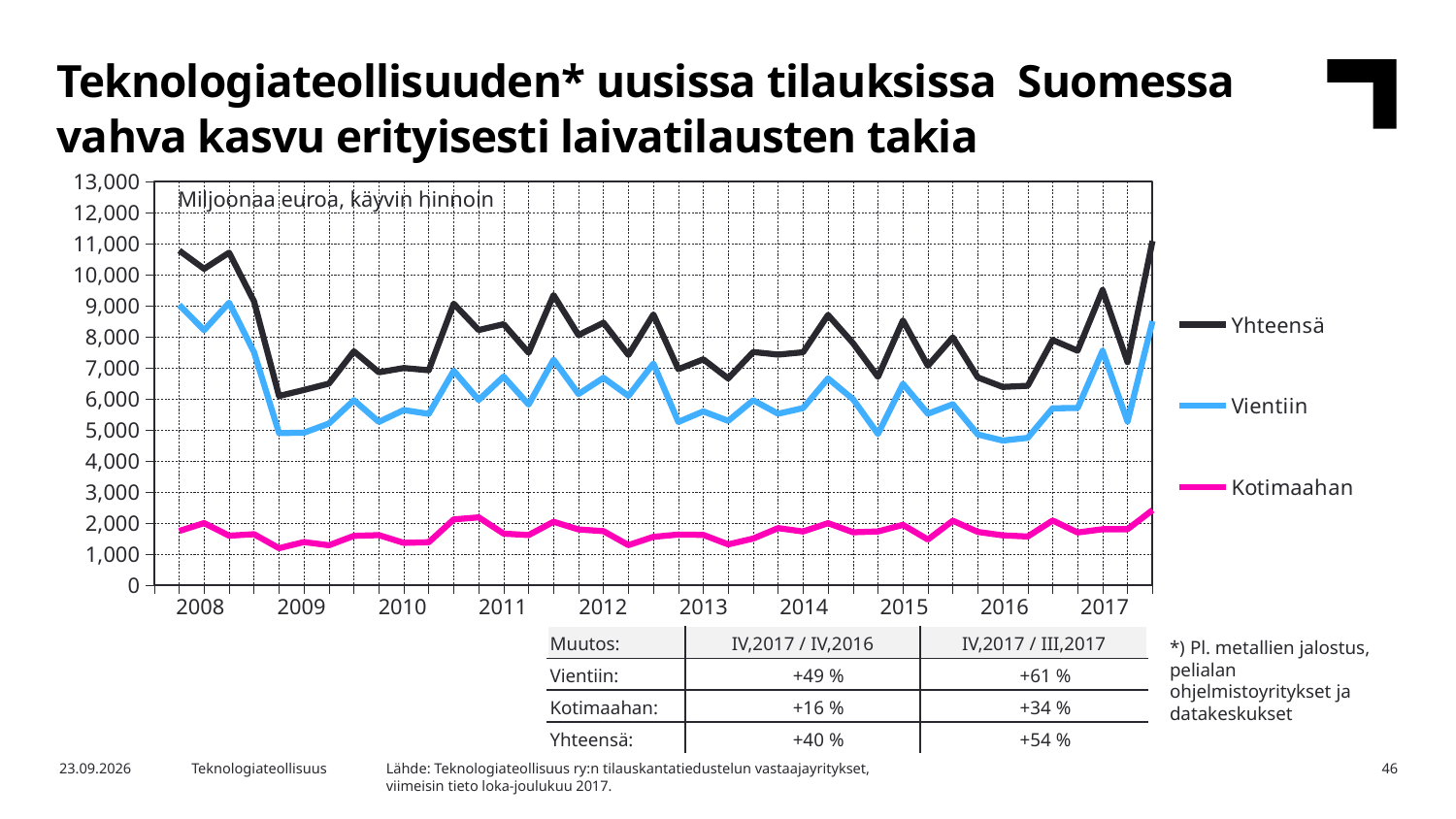
What unit label is printed inside the chart area? Miljoonaa euroa, käyvin hinnoin Which series is shown in black in the chart? Yhteensä Which series is larger at the start of 2008, Vientiin or Kotimaahan? Vientiin Is the last plotted value for Yhteensä in 2017 greater or less than 10,000? greater How many series does the chart legend list? 3 Is the value for Kotimaahan at the start of 2008 greater or less than 3,000? less Does the Yhteensä line rise or fall from the start of 2008 to 2009? fall Which series has the lowest values throughout the chart? Kotimaahan Is the value for Vientiin at the start of 2008 greater or less than 8,000? greater What kind of chart is shown on the slide? line chart How many year labels are shown on the x axis? 10 Which series has the highest values throughout the chart? Yhteensä